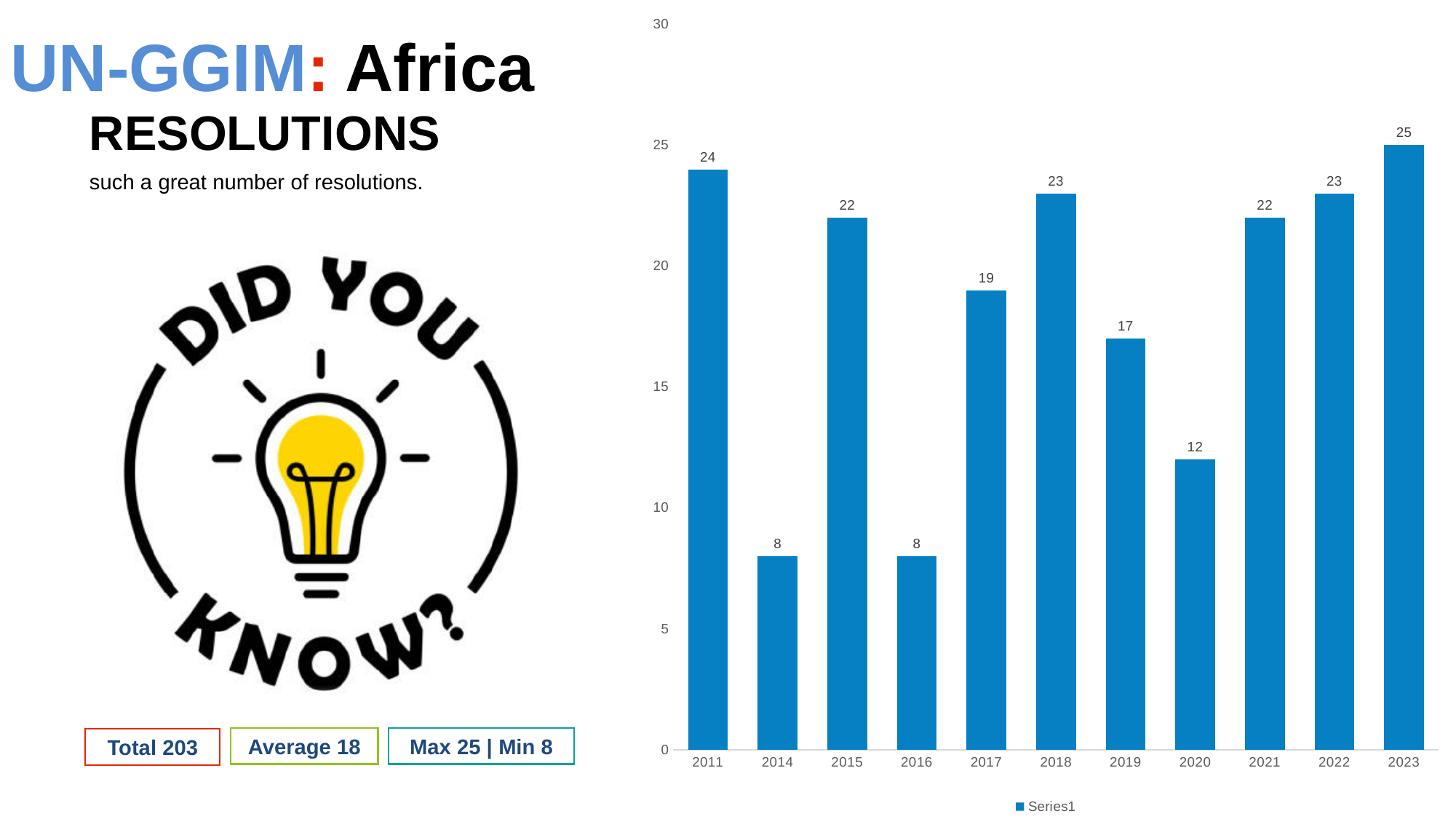
What is the difference between the values for 2023 and 2020? 13 How many series does the legend list? 1 What is the value for 2011? 24 What is the name of the series in the legend? Series1 Which is larger, the value for 2017 or the value for 2018? 2018 How many years are shown on the x axis? 11 What is the value for 2019? 17 What kind of chart is shown? bar chart Is the value for 2021 greater or less than 20? greater What is the value for 2020? 12 Do the values rise or fall from 2020 to 2023? rise Which year has the highest value? 2023